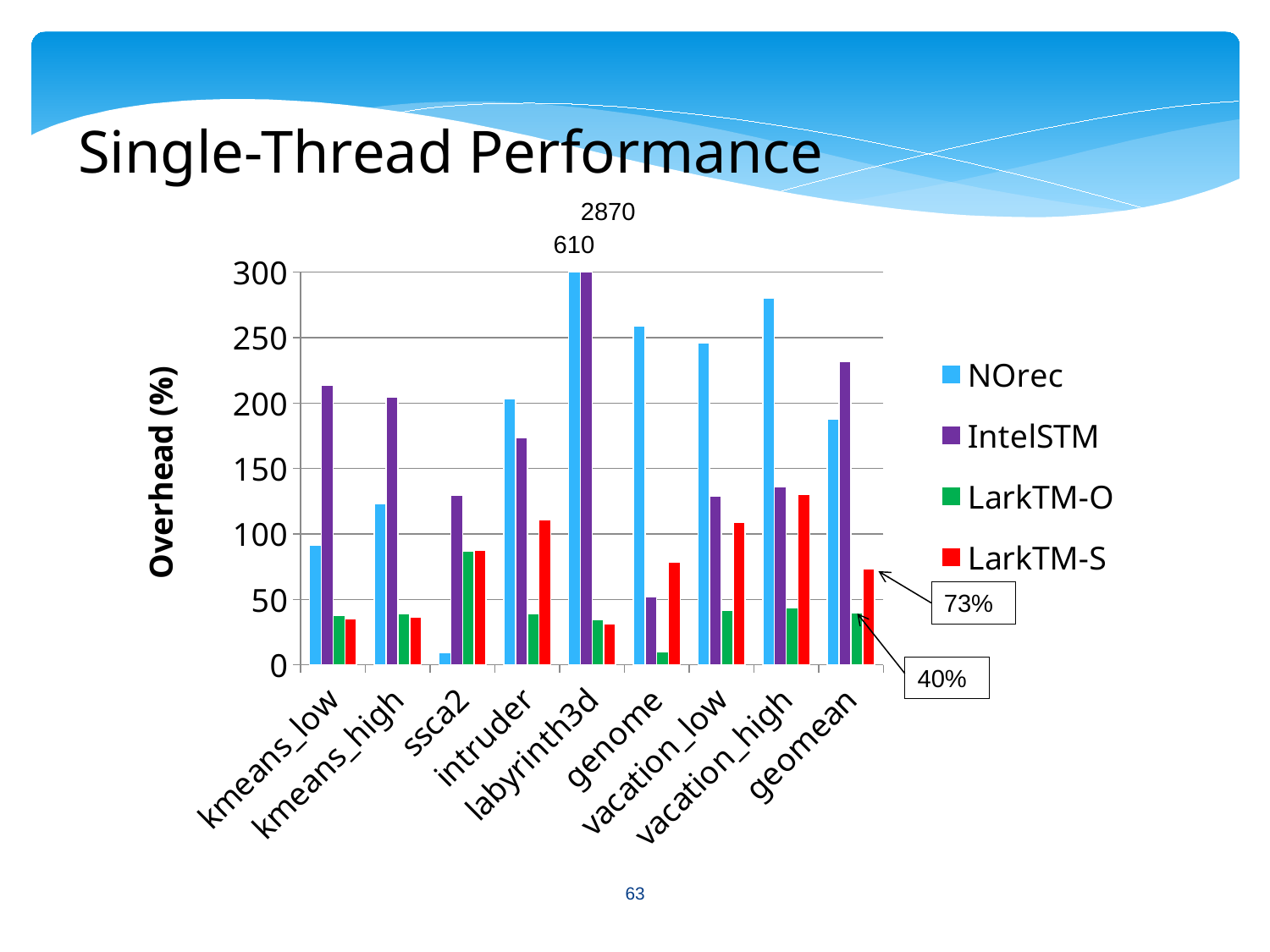
How many series does the legend list? 4 Is the NOrec overhead for vacation_high greater or less than 250? greater Which category has the lowest NOrec overhead? ssca2 What is the annotated LarkTM-S overhead for geomean? 73% What kind of chart is shown on the slide? bar chart What is the label of the y axis? Overhead (%) For vacation_high, which is larger: the NOrec overhead or the IntelSTM overhead? NOrec Which category has the highest NOrec overhead? labyrinth3d How many benchmark categories are shown on the x axis? 9 Is the NOrec overhead for ssca2 greater or less than 50? less What is the annotated LarkTM-O overhead for geomean? 40% For kmeans_low, which is larger: the NOrec overhead or the IntelSTM overhead? IntelSTM